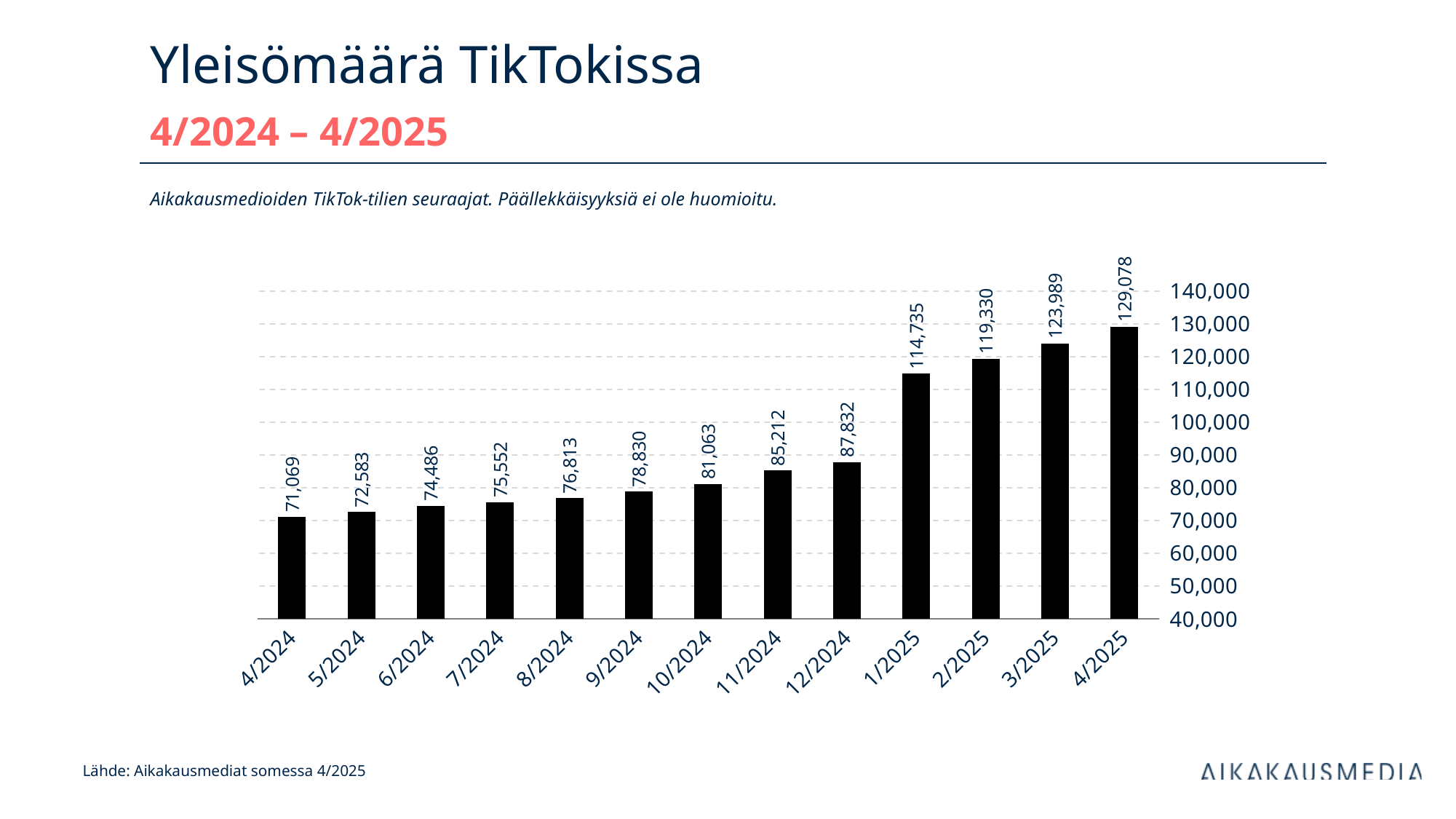
Which month has the lowest value? 4/2024 What is the value for 12/2024? 87,832 Is the value for 2/2025 greater or less than 110,000? greater What is the difference between the values for 1/2025 and 12/2024? 26,903 What kind of chart is shown on the slide? bar chart Which is larger, the value for 9/2024 or the value for 11/2024? 11/2024 What is the value for 1/2025? 114,735 What is the difference between the values for 4/2025 and 4/2024? 58,009 How many months are shown on the x axis? 13 Do the values rise or fall from 4/2024 to 4/2025? rise What is the value for 4/2024? 71,069 Which month has the highest value? 4/2025